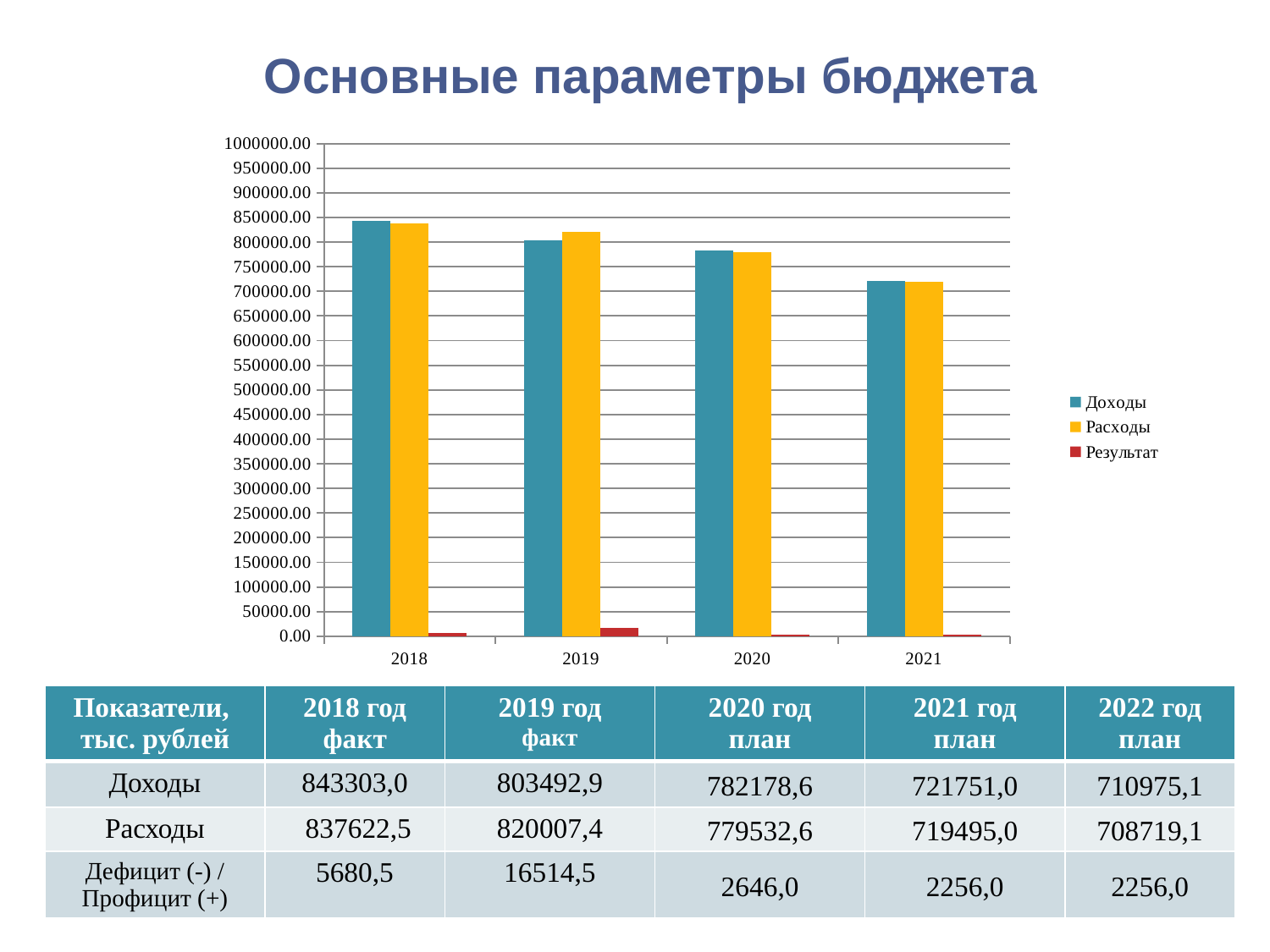
In which year is the Результат bar highest? 2019 According to the table on the slide, what is the Доходы value for 2018? 843303,0 In 2019, which is larger, Доходы or Расходы? Расходы How many series does the chart legend list? 3 Is the Доходы value for 2018 greater or less than 800000.00? greater In which year is the Доходы bar lowest? 2021 What are the three entries in the chart legend? Доходы, Расходы, Результат Do the Доходы bars rise or fall from 2018 to 2021? fall How many years are shown on the x axis of the chart? 4 Is the Расходы value for 2021 greater or less than 750000.00? less What kind of chart is shown on the slide? bar chart In which year is the Доходы bar highest? 2018